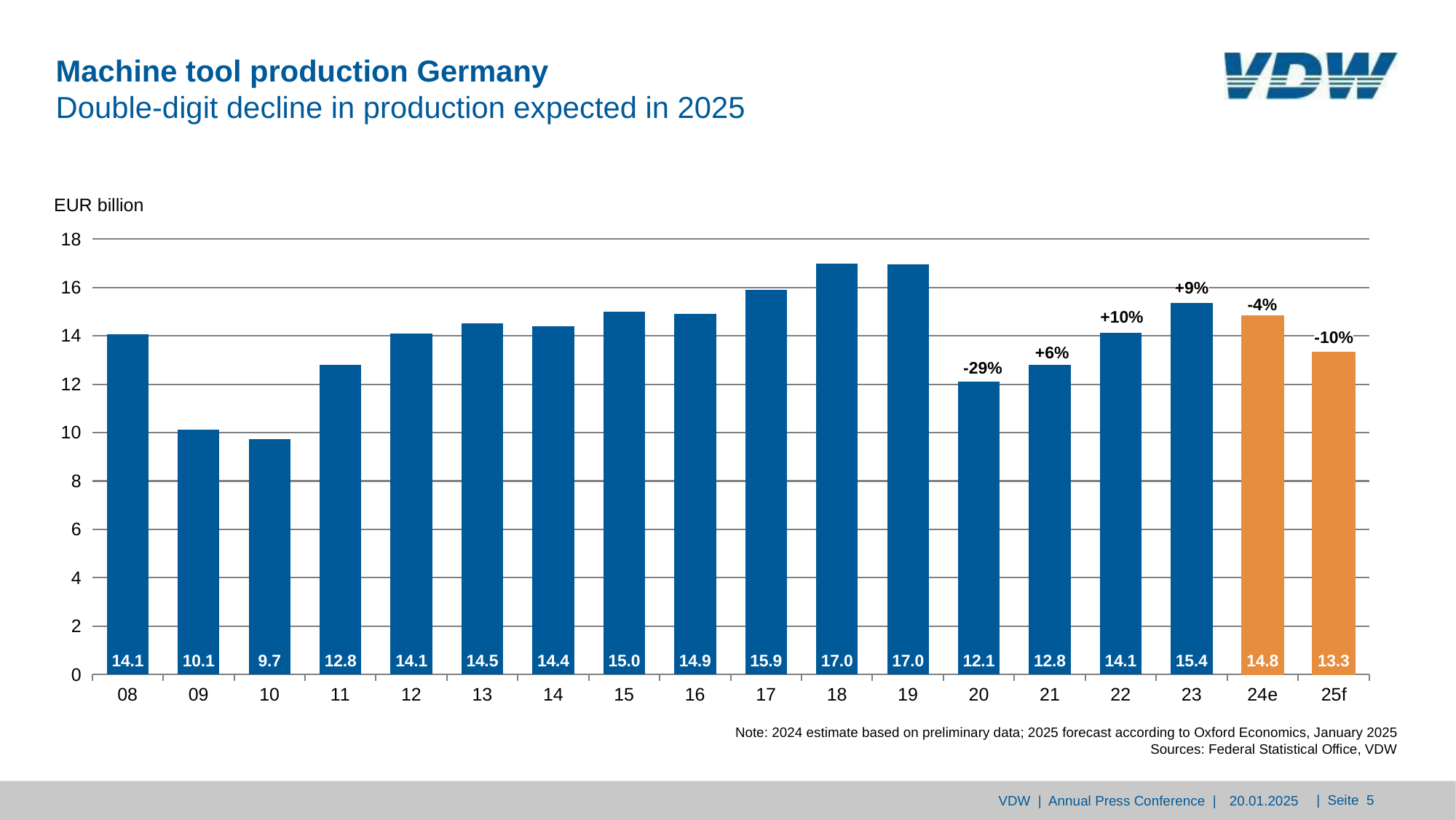
Which is larger, the value for 09 or the value for 20? 20 What type of chart is shown on the slide? Bar chart Do the values rise or fall from 20 to 23? Rise What is the value shown for the 2025 forecast (25f)? 13.3 How many bars (years) are shown in the chart? 18 What is the highest production value shown in the chart? 17.0 Which year has the lowest machine tool production value? 10 What is the value shown for the 2024 estimate (24e)? 14.8 What unit is given for the y axis of the chart? EUR billion What is the machine tool production value for 2010 (bar labelled 10)? 9.7 What percentage change is labelled above the bar for 20? -29% What is the difference between the values for 23 and 25f? 2.1